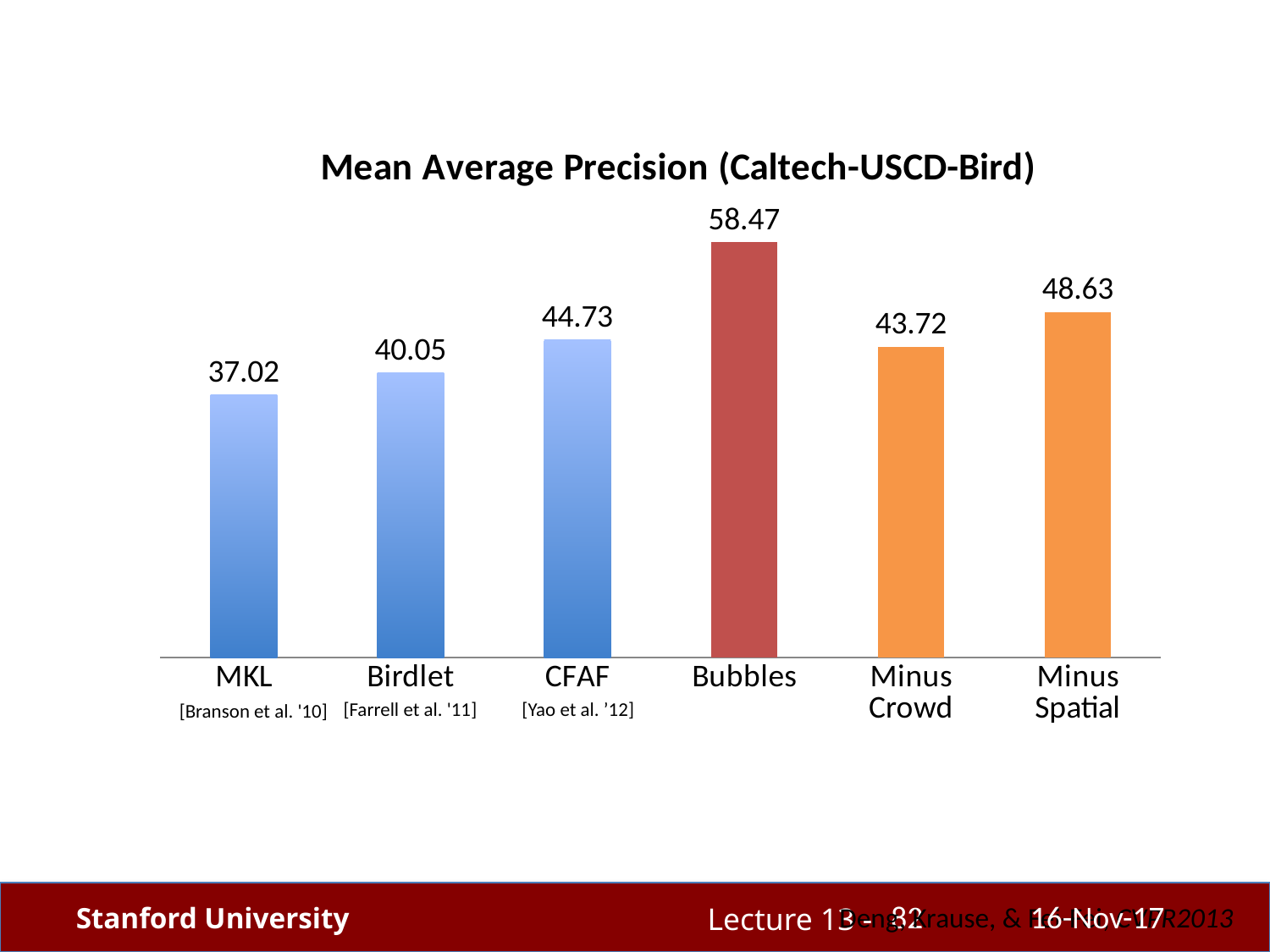
What is the title of the chart? Mean Average Precision (Caltech-USCD-Bird) How many methods (bars) are shown in the chart? 6 Which has a higher value, Birdlet or Minus Crowd? Minus Crowd What is the value shown for MKL? 37.02 Which method has the lowest Mean Average Precision? MKL What colour is the bar for Bubbles? Red What is the value shown for Minus Spatial? 48.63 What type of chart is shown on the slide? Bar chart What is the difference between the values for Minus Spatial and Minus Crowd? 4.91 What is the Mean Average Precision value for Bubbles? 58.47 Which method has the highest Mean Average Precision? Bubbles What is the difference between the values for Bubbles and CFAF? 13.74